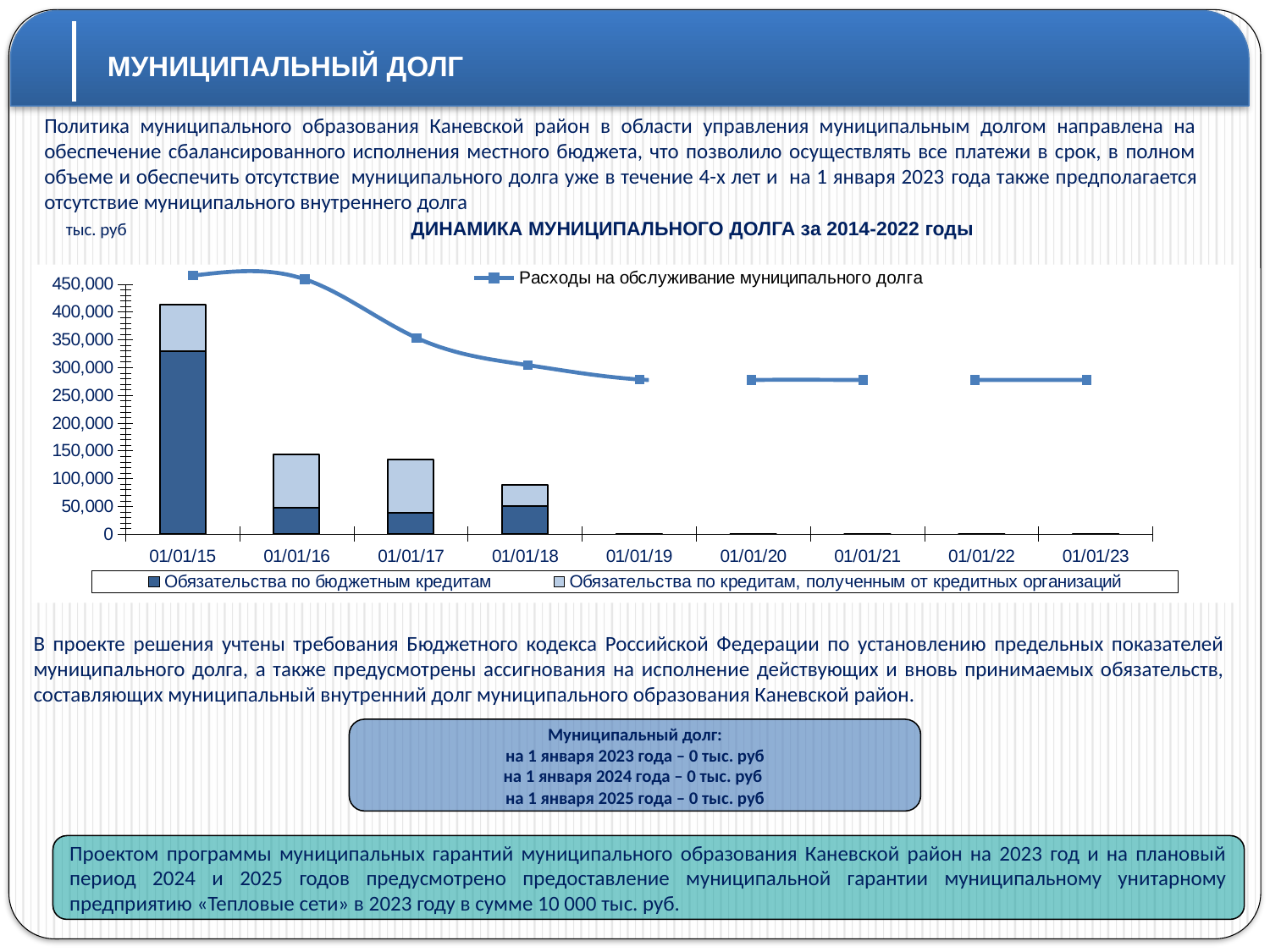
Is the value of 'Обязательства по бюджетным кредитам' for 01/01/17 greater or less than 50,000? less Is the total stacked bar for 01/01/16 greater or less than 100,000? greater What kind of chart is shown on the slide? Bar chart (stacked bars with a line) How many series does the chart's legend list in total? 3 How many dates are shown on the x axis of the chart? 9 Do the stacked bars rise or fall from 01/01/15 to 01/01/19? fall Is the total stacked bar for 01/01/18 greater or less than 100,000? less What is the title of the chart? ДИНАМИКА МУНИЦИПАЛЬНОГО ДОЛГА за 2014-2022 годы Which has the larger total stacked bar, 01/01/15 or 01/01/18? 01/01/15 On which date is the total stacked bar the highest? 01/01/15